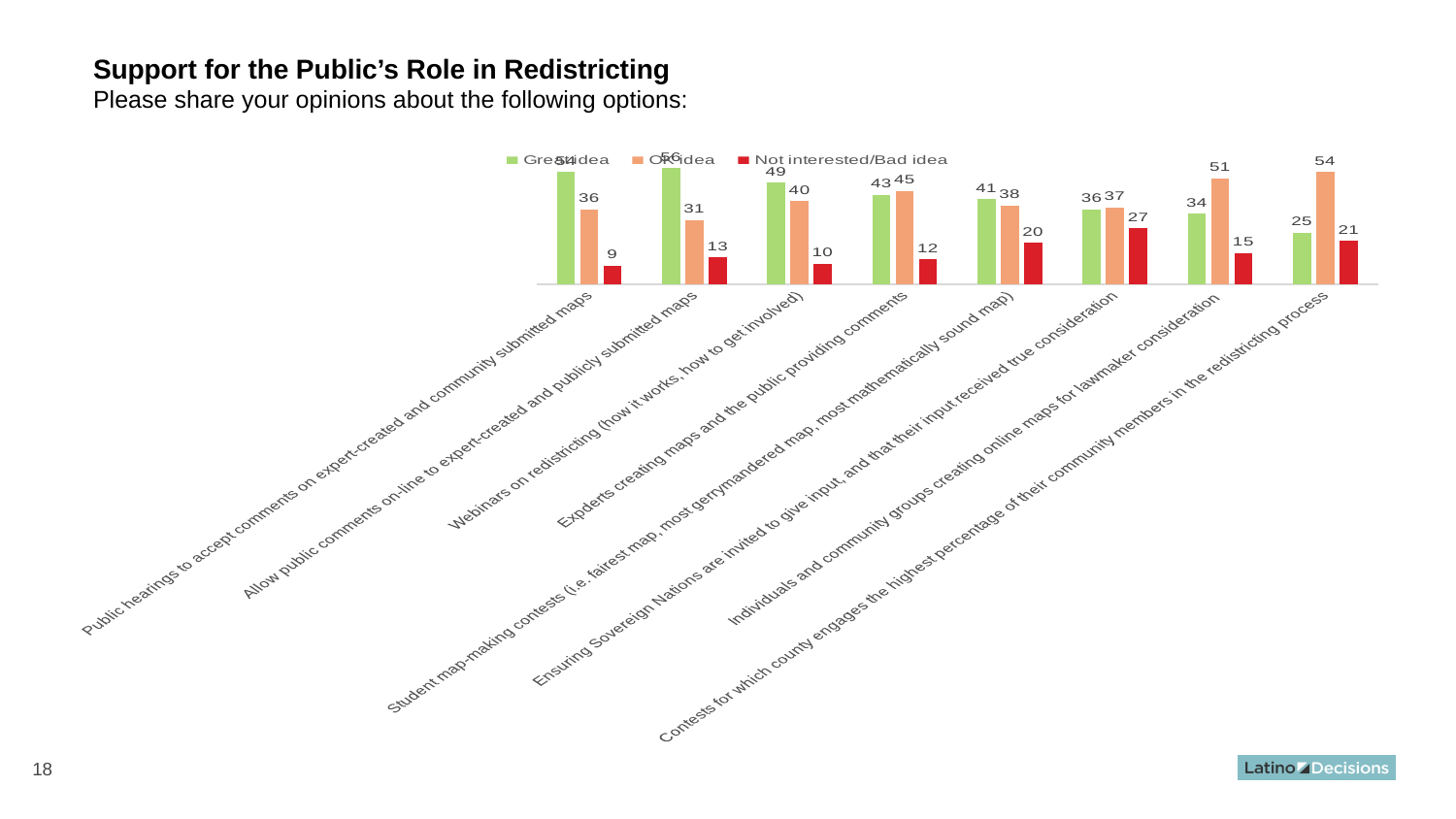
For "Experts creating maps and the public providing comments", which is larger: "Great idea" or "OK idea"? OK idea Which option has the lowest "Not interested/Bad idea" value? Public hearings to accept comments on expert-created and community submitted maps What is the value for "OK idea" for "Individuals and community groups creating online maps for lawmaker consideration"? 51 What is the value for "Great idea" for "Webinars on redistricting (how it works, how to get involved)"? 49 What kind of chart is shown on the slide? Bar chart Which option has the highest "Not interested/Bad idea" value? Ensuring Sovereign Nations are invited to give input, and that their input received true consideration How many series does the legend list? 3 What is the value for "Great idea" for "Contests for which county engages the highest percentage of their community members in the redistricting process"? 25 What is the difference between the "Great idea" and "OK idea" values for "Webinars on redistricting (how it works, how to get involved)"? 9 What is the value for "Not interested/Bad idea" for "Ensuring Sovereign Nations are invited to give input, and that their input received true consideration"? 27 How many options (categories) are shown on the chart? 8 Which option has the highest "OK idea" value? Contests for which county engages the highest percentage of their community members in the redistricting process